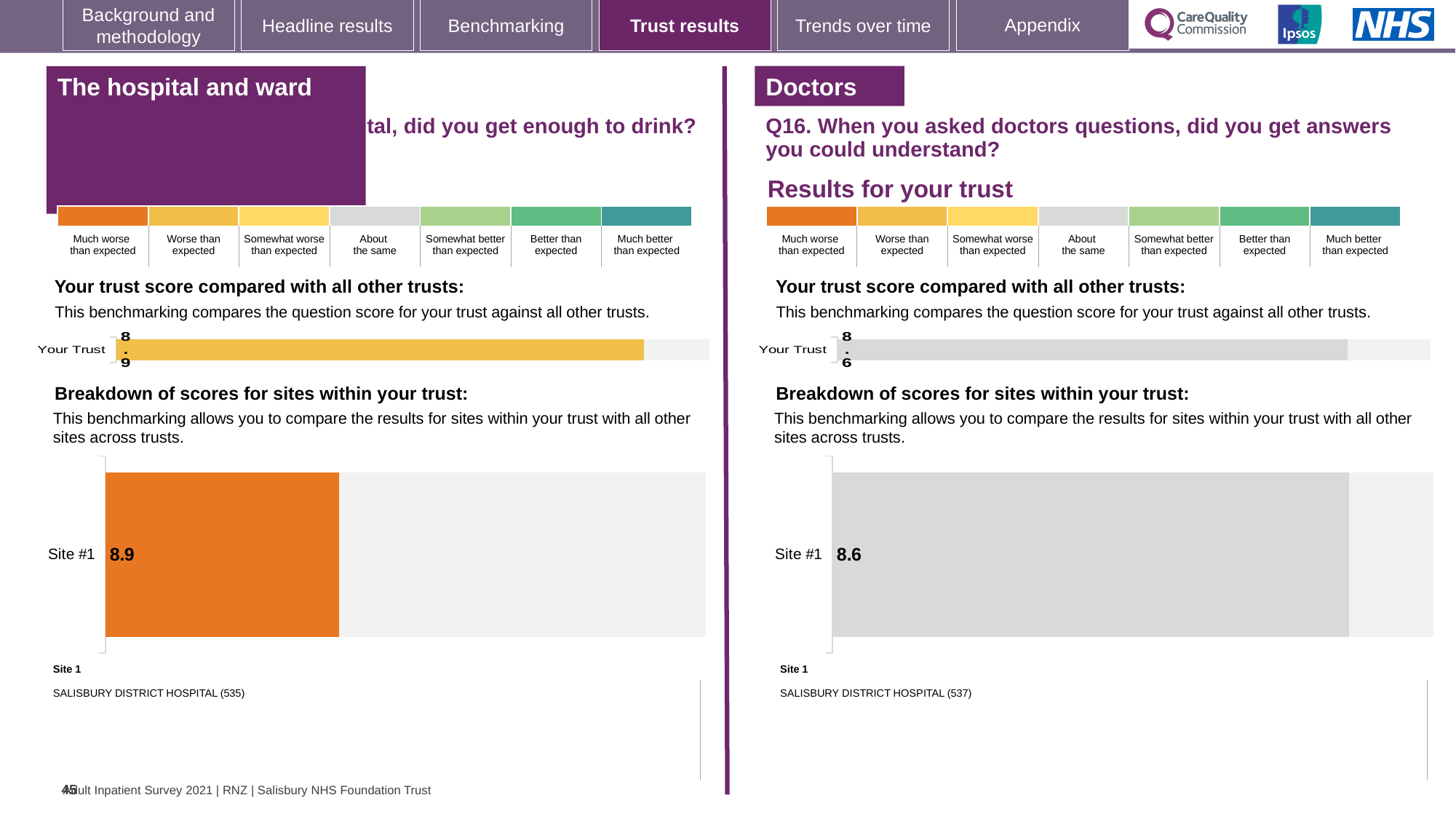
What colour is the Site #1 bar in the left-hand section's breakdown of scores chart? Orange What colour is the Site #1 bar in the right-hand section's (Doctors, Q16) breakdown of scores chart? Grey What kind of chart is used to show the Site #1 score in the breakdown of scores for sites within your trust? Bar chart Which section shows the higher Site #1 score: the left-hand (hospital and ward) section or the right-hand (Doctors, Q16) section? The left-hand (hospital and ward) section Is the 'Your Trust' score in the left-hand section (8.9) greater or less than the 'Your Trust' score in the right-hand section (8.6)? Greater In the left-hand section (The hospital and ward), what is the 'Your Trust' score shown on the trust comparison bar? 8.9 In the right-hand section (Doctors, Q16), what score is shown for Site #1 in the breakdown of scores chart? 8.6 What is the difference between the Site #1 score in the left-hand section (8.9) and the Site #1 score in the right-hand section (8.6)? 0.3 In the left-hand section (The hospital and ward), what score is shown for Site #1 in the breakdown of scores chart? 8.9 How many sites are shown in the breakdown of scores chart in the right-hand section (Doctors, Q16)? 1 How many rating categories are shown in the colour key above the trust comparison chart in the right-hand section (Doctors, Q16)? 7 In the right-hand section (Doctors, Q16), what is the 'Your Trust' score shown on the trust comparison bar? 8.6